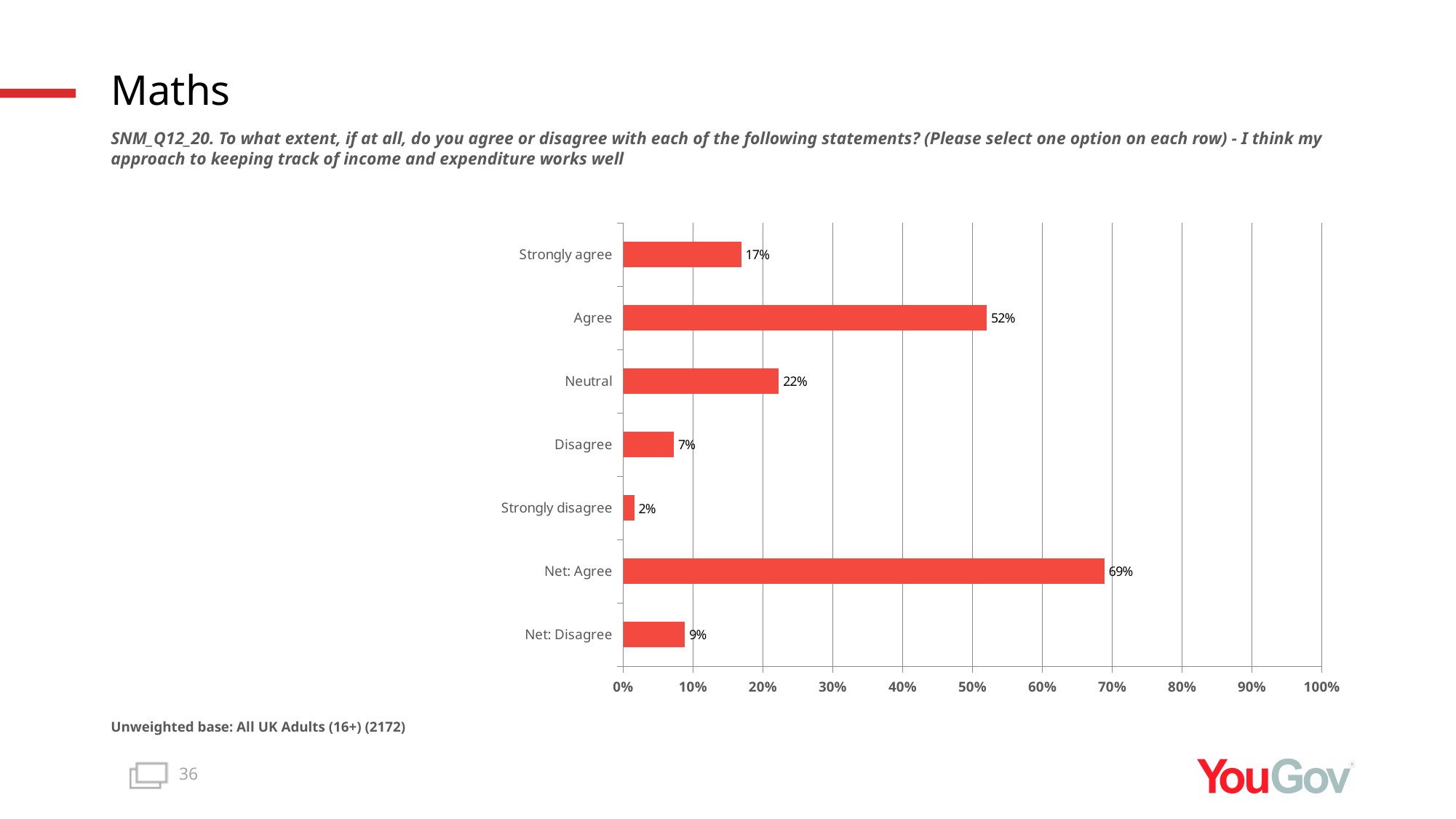
What percentage of respondents selected 'Agree'? 52% What kind of chart is shown on the slide? Bar chart How many categories are shown on the chart? 7 Is the value for 'Agree' greater or less than 50%? greater What is the difference between the 'Net: Agree' and 'Net: Disagree' values? 60% What is the value shown for 'Strongly disagree'? 2% Which category has the highest value on the chart? Net: Agree Which category has the lowest value on the chart? Strongly disagree What is the difference between the 'Disagree' and 'Strongly disagree' values? 5% Which is larger, the value for 'Neutral' or the value for 'Strongly agree'? Neutral What is the value for 'Net: Agree'? 69% What is the maximum value shown on the horizontal axis? 100%